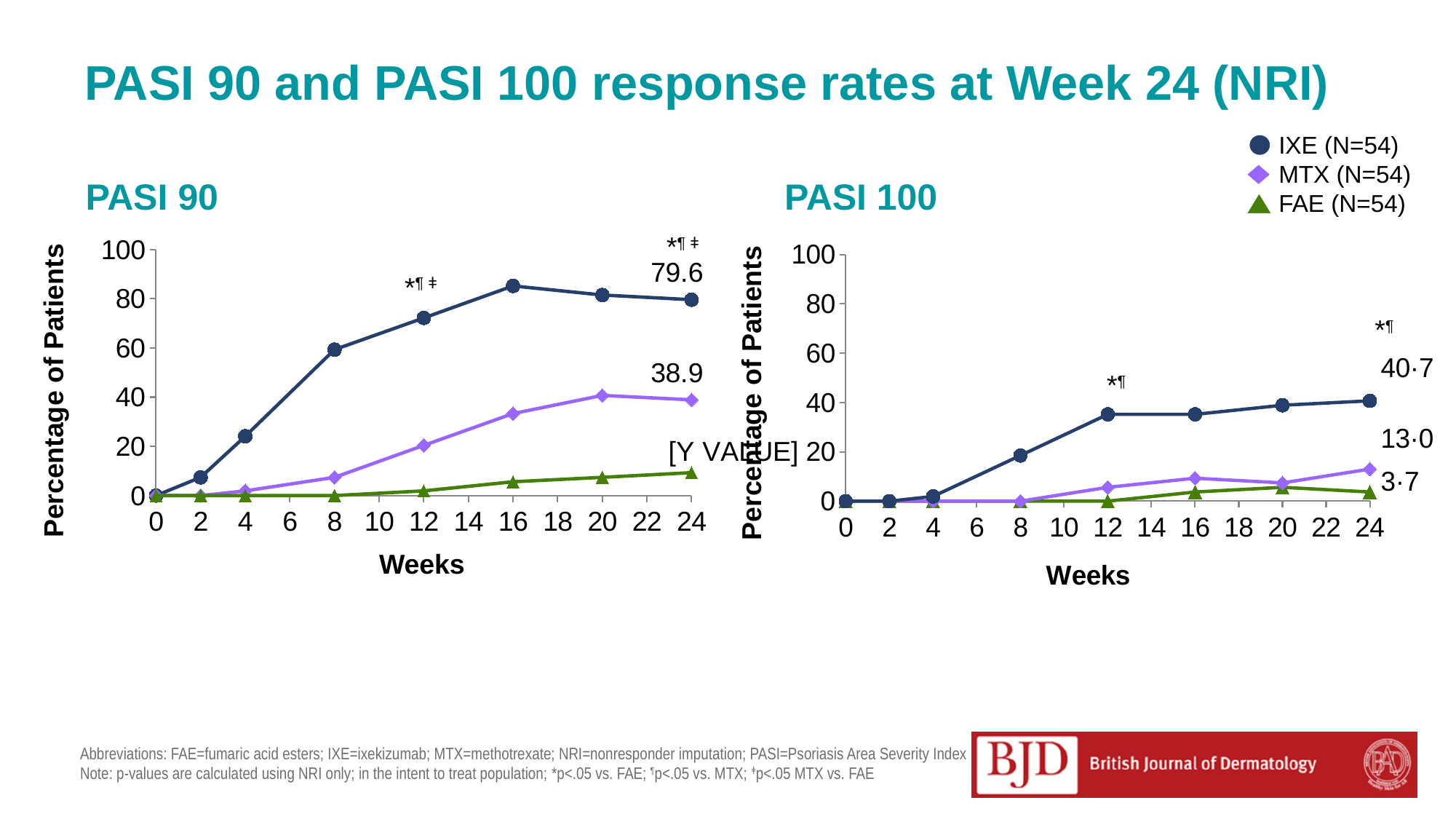
In the PASI 90 chart, what is the MTX response rate at Week 24? 38.9 In the PASI 90 chart, what is the IXE response rate at Week 24? 79.6 How many series does the legend list? 3 In the PASI 100 chart, which treatment has the lowest response rate at Week 24? FAE In the PASI 90 chart, which treatment has the highest response rate at Week 24? IXE In the PASI 90 chart, what is the difference between the IXE and MTX response rates at Week 24? 40.7 What kind of chart is the PASI 100 chart? Line chart In the PASI 100 chart, what is the difference between the IXE and FAE response rates at Week 24? 37·0 In the PASI 100 chart, what is the IXE response rate at Week 24? 40·7 In the PASI 90 chart, is the IXE value at Week 8 greater or less than 40? greater In the PASI 100 chart, what is the FAE response rate at Week 24? 3·7 In the PASI 100 chart, what is the MTX response rate at Week 24? 13·0